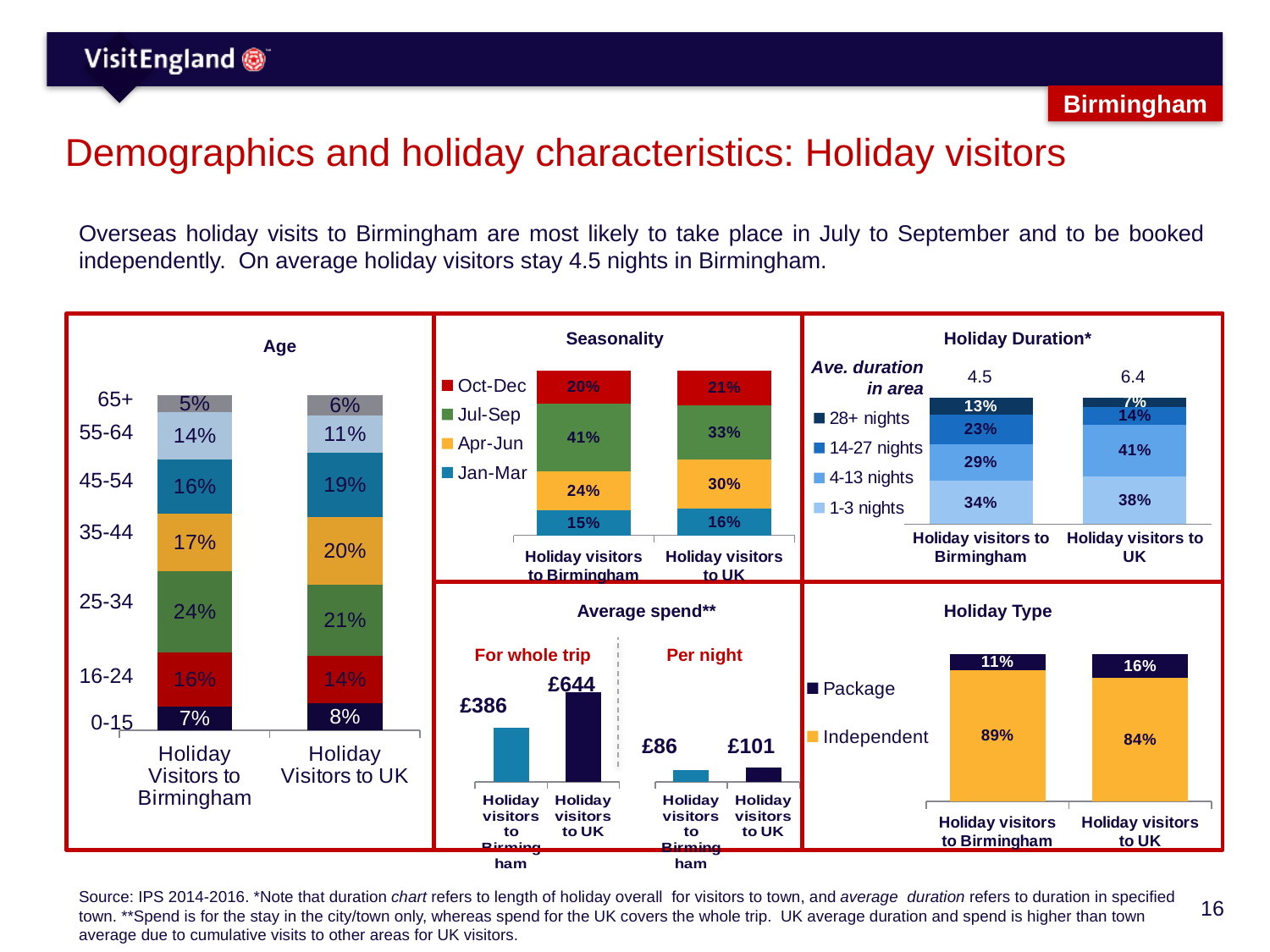
In the Holiday Duration chart, what is the average duration in area for holiday visitors to Birmingham? 4.5 In the Holiday Type chart, what share of holiday visitors to Birmingham are on a package holiday? 11% In the Seasonality chart, what is the difference between the Apr-Jun share for holiday visitors to UK and for holiday visitors to Birmingham? 6% In the Age chart, which age group is the smallest for holiday visitors to Birmingham? 65+ In the Age chart, what share of holiday visitors to Birmingham are aged 25-34? 24% In the Seasonality chart, what share of holiday visitors to Birmingham visit in Jul-Sep? 41% In the Holiday Duration chart, what share of holiday visitors to UK stay 4-13 nights? 41% In the Seasonality chart, how many series does the legend list? 4 In the Average spend chart, what is the difference in per night spend between holiday visitors to UK and holiday visitors to Birmingham? £15 What kind of chart is the Holiday Type chart? Stacked bar chart In the Average spend chart, what is the average spend for the whole trip for holiday visitors to UK? £644 In the Age chart, which age group is the largest for holiday visitors to UK? 25-34